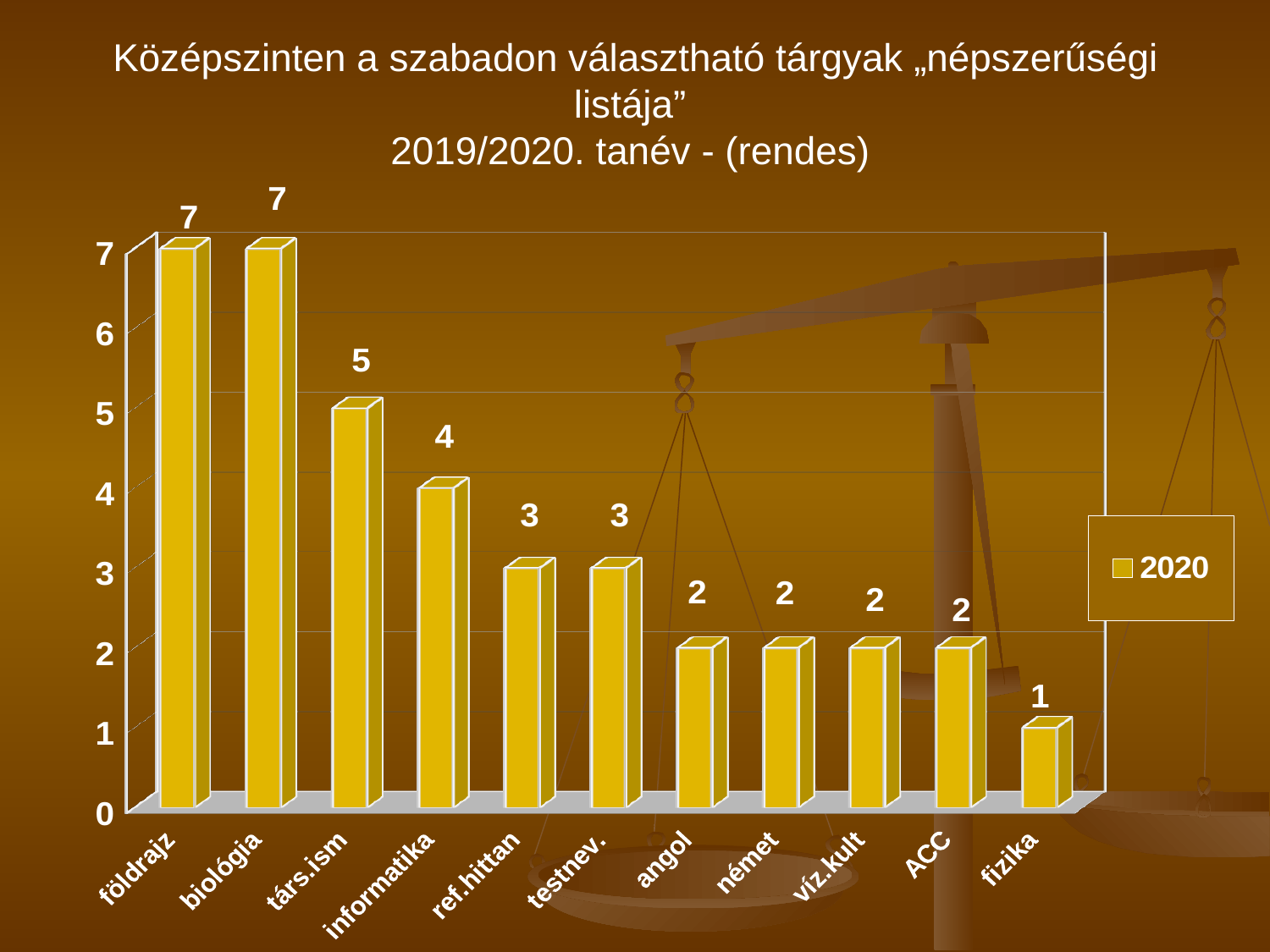
What is the value for fizika? 1 What is the value for informatika? 4 Do the values rise or fall from left to right along the x axis? fall What is the value for földrajz? 7 Which category has the lowest value? fizika Which is larger, the value for társ.ism or the value for angol? társ.ism What kind of chart is shown on the slide? bar chart What is the legend entry for the series? 2020 How many series does the legend list? 1 What is the difference between the values for biológia and ref.hittan? 4 What is the value for társ.ism? 5 How many categories are shown on the x axis? 11